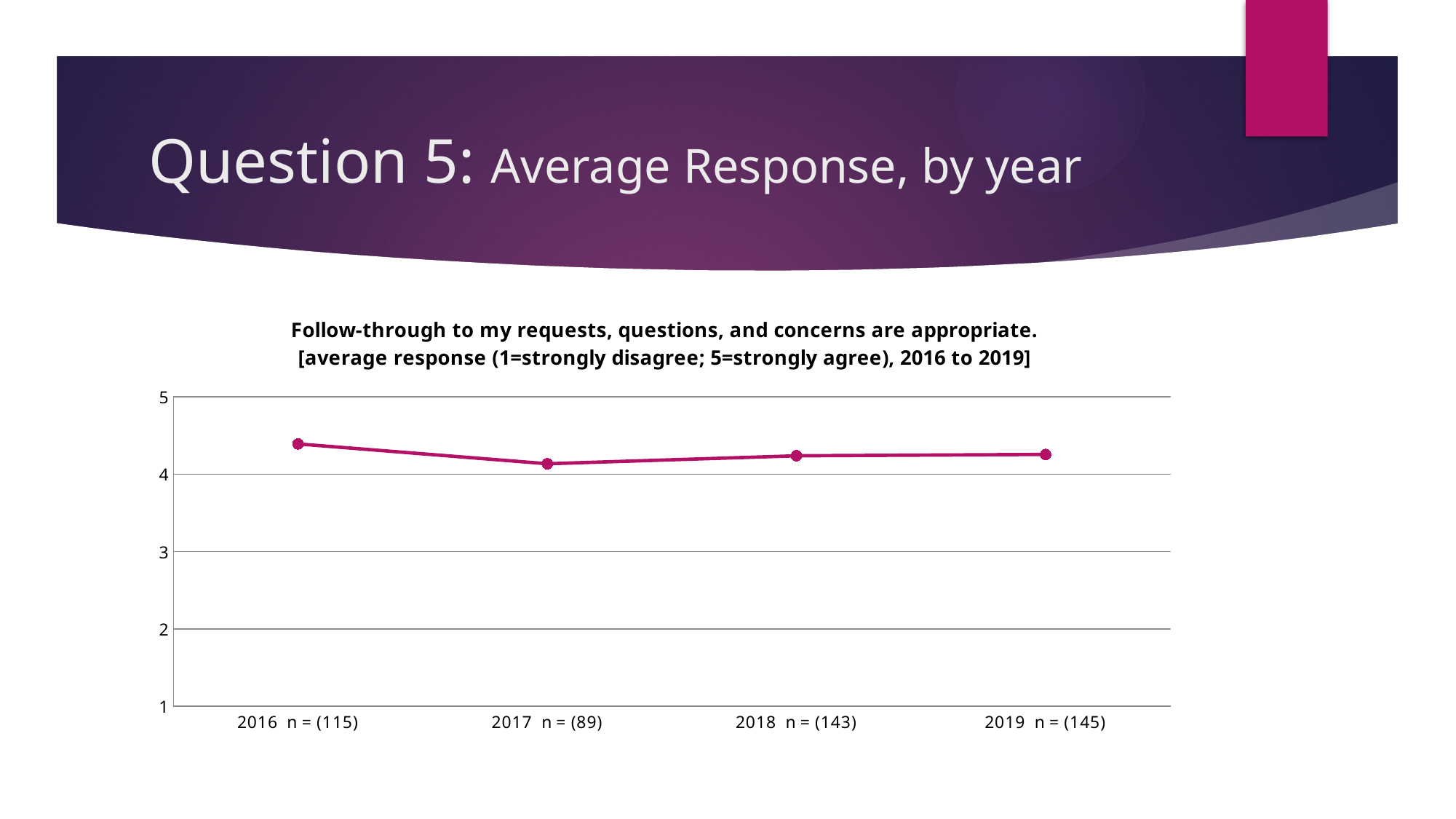
Is the average response for 2016 greater or less than 5? less What is the sample size (n) shown for 2017? 89 What is the sample size (n) shown for 2019? 145 How many data points are plotted on the line? 4 What survey statement is the chart about, according to its title? Follow-through to my requests, questions, and concerns are appropriate. Which year has the highest average response? 2016 Is the average response for 2017 greater or less than 4? greater Which year has a higher average response, 2016 or 2017? 2016 Does the average response rise or fall from 2016 to 2017? fall Which year has the lowest average response? 2017 What kind of chart is shown on the slide? line chart Is the average response for 2019 greater or less than 4? greater